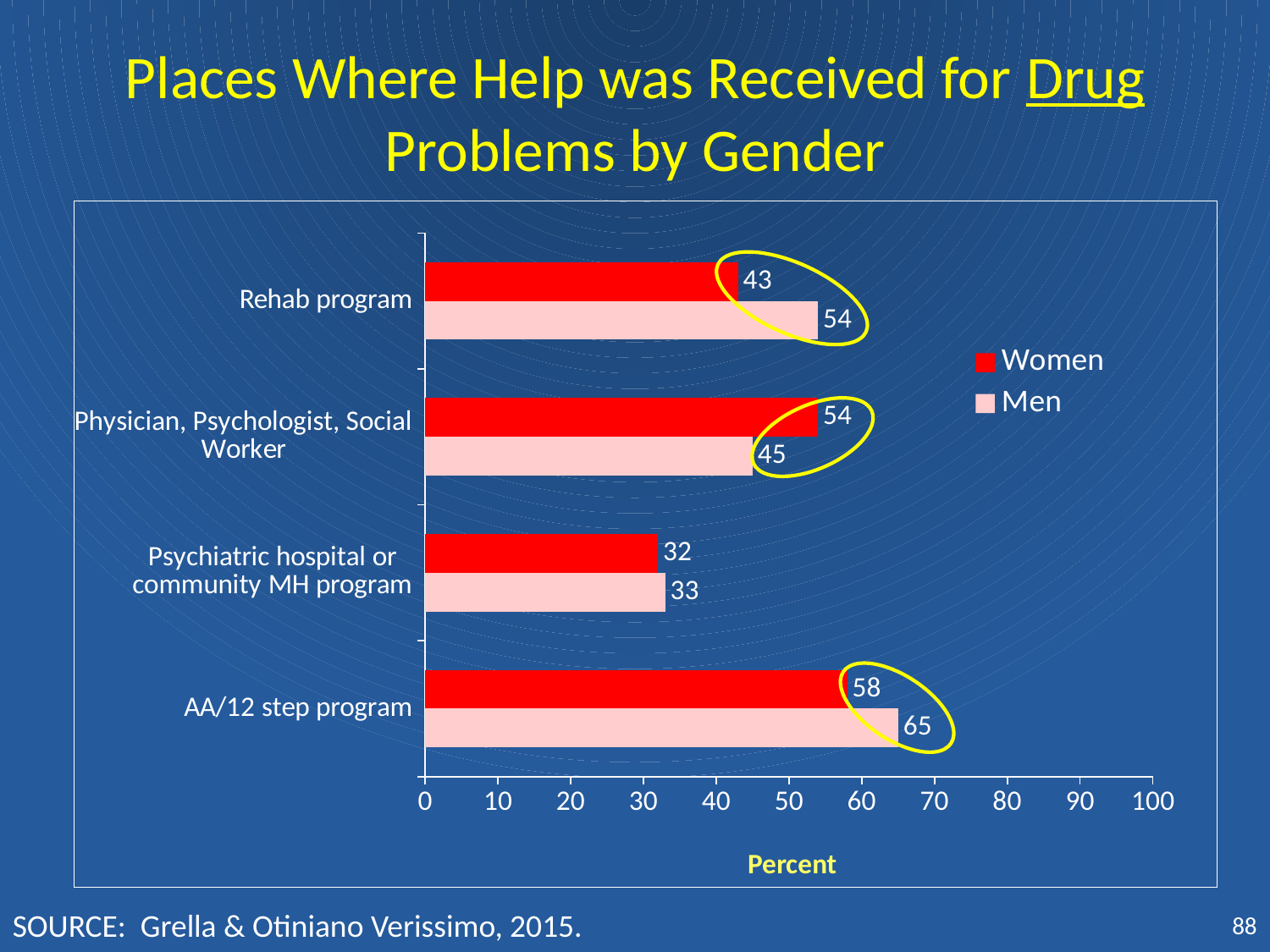
Which category has the lowest value for Women? Psychiatric hospital or community MH program How many series does the legend list? 2 What is the value for Women for Rehab program? 43 How many categories are shown on the chart? 4 For Physician, Psychologist, Social Worker, which is larger: the value for Women or the value for Men? Women Which category has the highest value for Men? AA/12 step program What kind of chart is shown on the slide? Bar chart What is the value for Men for AA/12 step program? 65 What is the label of the horizontal axis? Percent What is the difference between the Men and Women values for AA/12 step program? 7 What is the value for Men for Physician, Psychologist, Social Worker? 45 What is the difference between the Men and Women values for Rehab program? 11